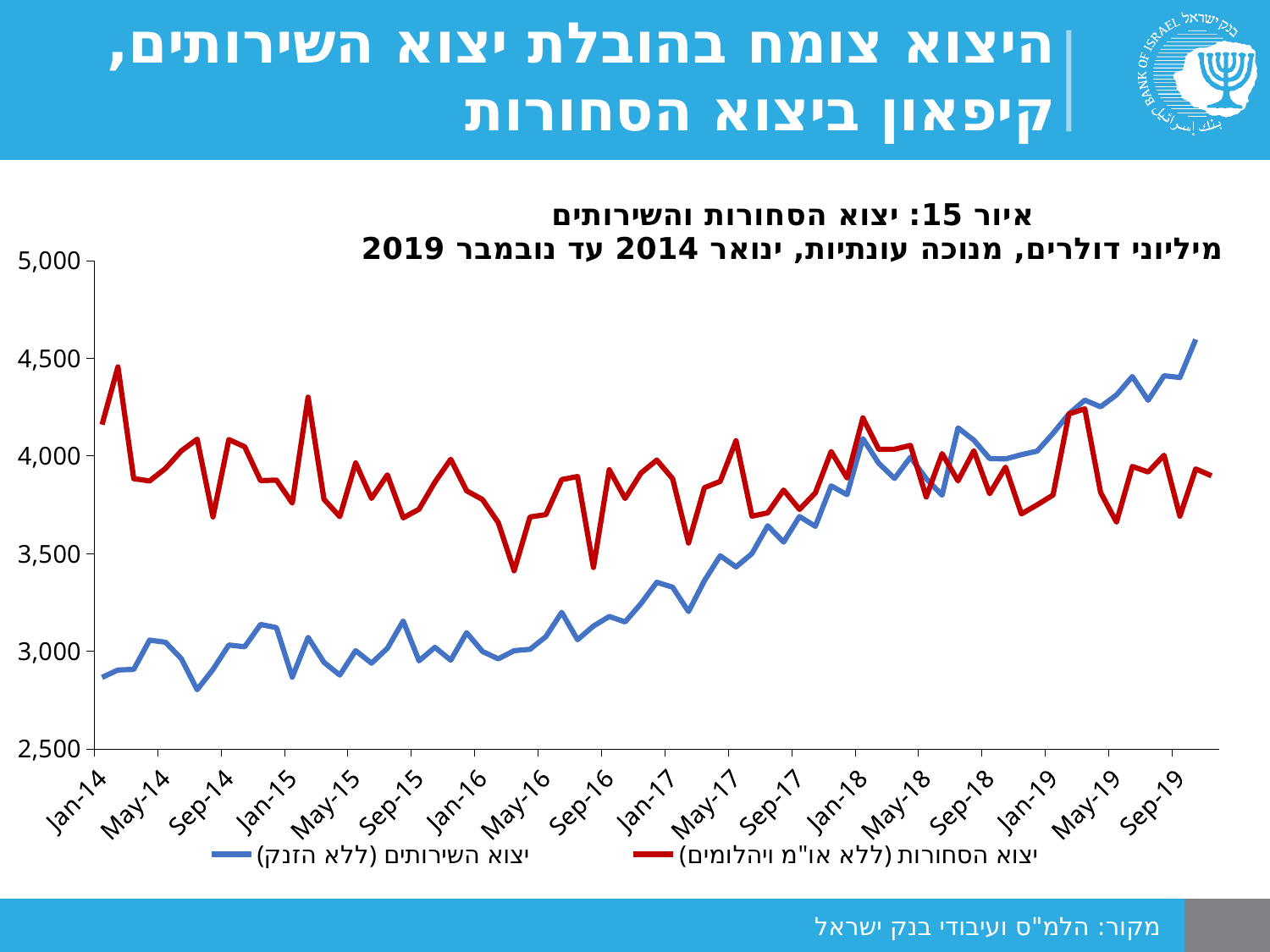
Is the value of יצוא השירותים (ללא הזנק) at the last point (after Sep-19) greater or less than 4,500? greater Does the line for יצוא השירותים (ללא הזנק) rise or fall overall from Jan-14 to the end of the period? rise At the end of the period (after Sep-19), which series has the higher value: יצוא השירותים (ללא הזנק) or יצוא הסחורות (ללא או"מ ויהלומים)? יצוא השירותים (ללא הזנק) Which colour is the line for יצוא השירותים (ללא הזנק)? blue What is the figure number given in the chart title? איור 15 How many series does the legend list? 2 At Jan-14, which series has the higher value: יצוא השירותים (ללא הזנק) or יצוא הסחורות (ללא או"מ ויהלומים)? יצוא הסחורות (ללא או"מ ויהלומים) What kind of chart is shown on the slide? line chart Is the value of יצוא השירותים (ללא הזנק) at Jan-14 greater or less than 3,000? less How many date labels are shown on the x axis? 18 Is the value of יצוא הסחורות (ללא או"מ ויהלומים) at Jan-14 greater or less than 4,000? greater